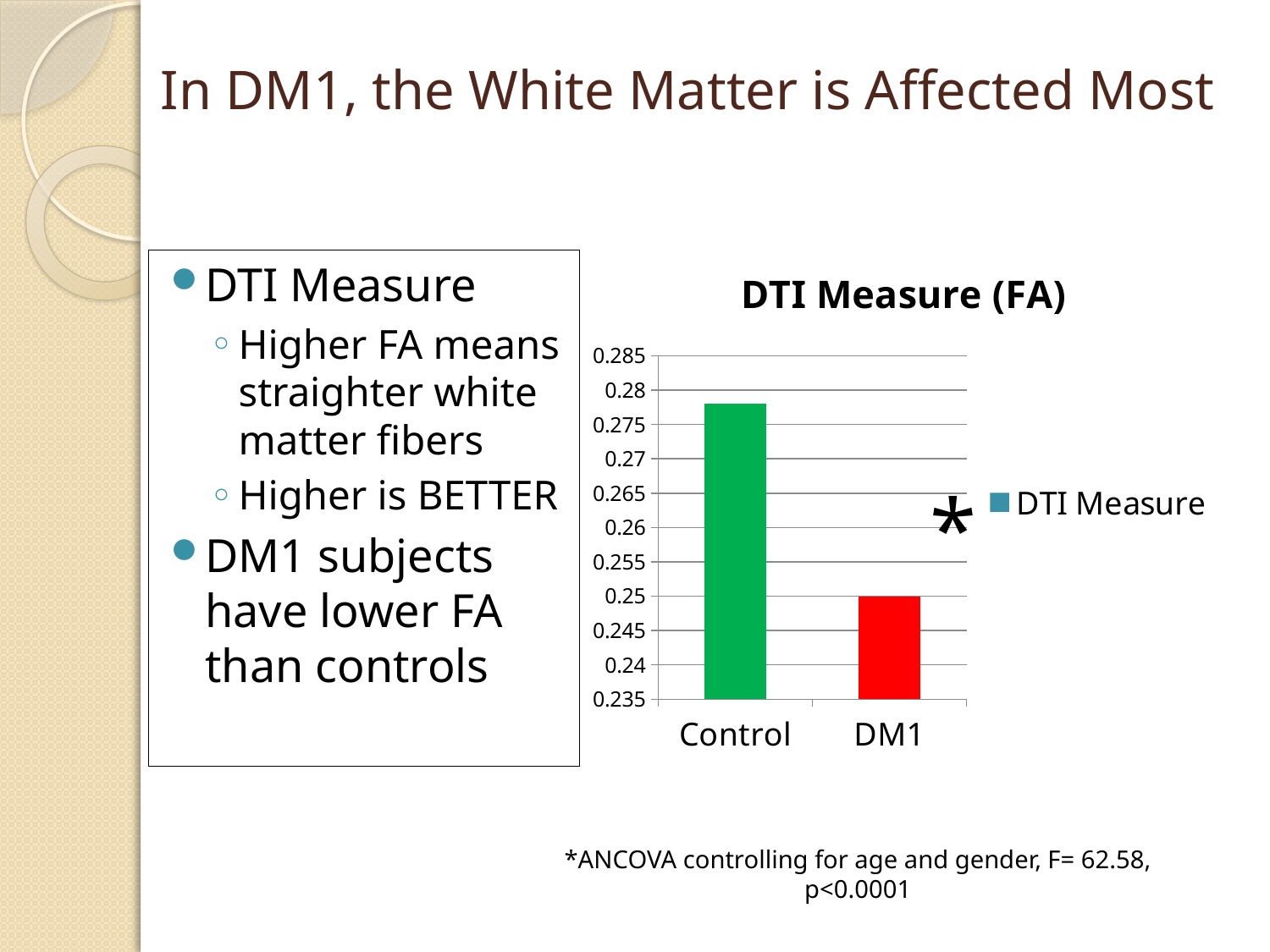
Which category has the highest value in the chart? Control Is the value for Control greater or less than 0.275? greater What is the title of the chart? DTI Measure (FA) Do the values rise or fall from Control to DM1 along the x axis? fall Which category has the lowest value in the chart? DM1 Is the value for DM1 greater or less than 0.26? less How many series does the chart legend list? 1 Which has a larger value, Control or DM1? Control What is the name of the series listed in the chart legend? DTI Measure Is the value for Control greater or less than 0.28? less How many categories are shown on the x axis of the chart? 2 What kind of chart is shown on the slide? bar chart